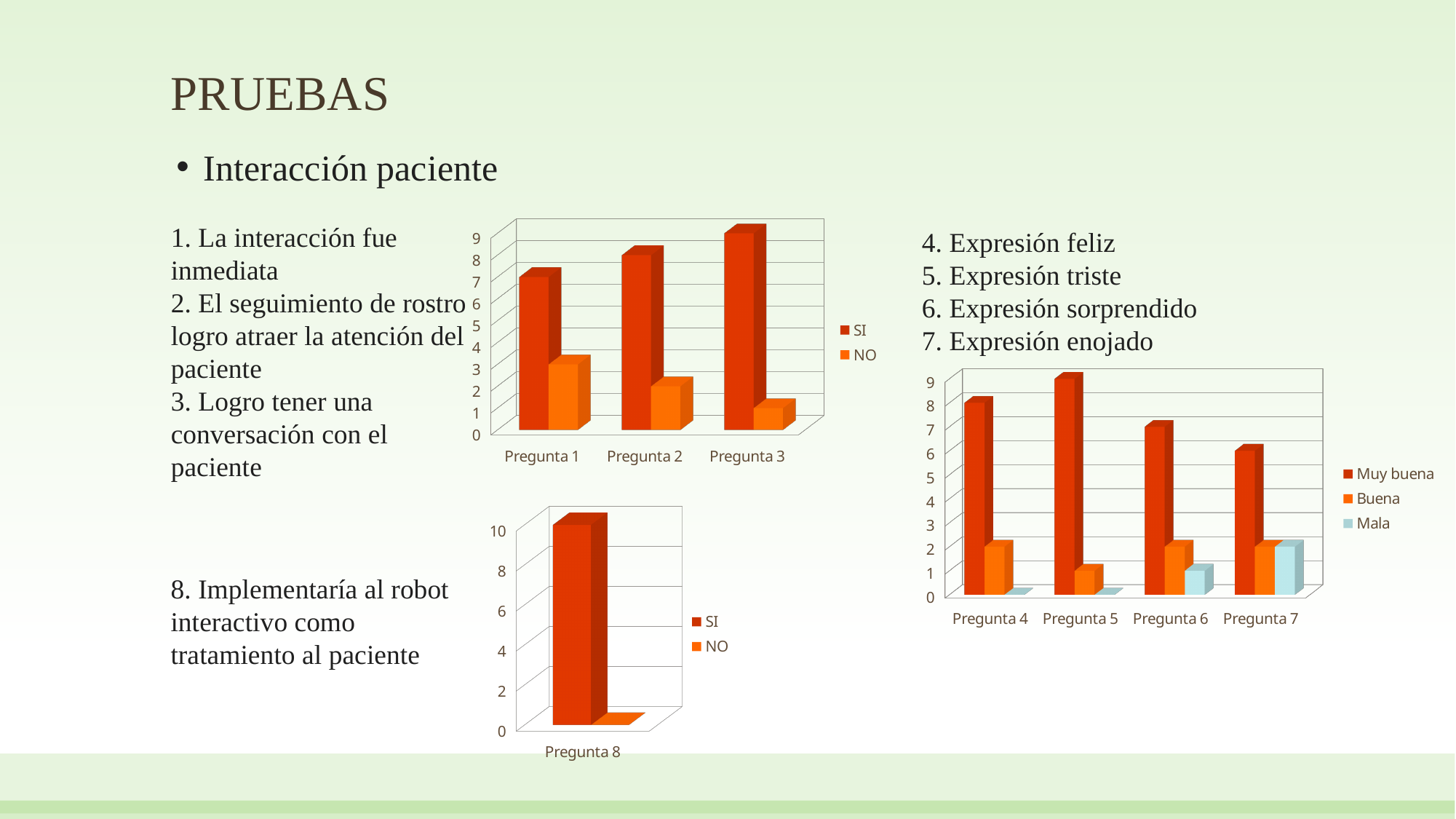
In the top-left chart (Pregunta 1 to Pregunta 3), how many series does the legend list? 2 What kind of chart is the bottom-left chart (Pregunta 8)? bar chart In the right chart (Pregunta 4 to Pregunta 7), how many series does the legend list? 3 In the right chart (Pregunta 4 to Pregunta 7), how many categories are shown on the x axis? 4 In the bottom-left chart (Pregunta 8), is the SI value greater or less than 8? greater In the right chart (Pregunta 4 to Pregunta 7), which category has the highest Muy buena value? Pregunta 5 In the right chart (Pregunta 4 to Pregunta 7), which has the larger Mala value, Pregunta 4 or Pregunta 7? Pregunta 7 In the top-left chart (Pregunta 1 to Pregunta 3), do the SI values rise or fall from Pregunta 1 to Pregunta 3? rise In the bottom-left chart (Pregunta 8), which is larger, SI or NO? SI In the top-left chart (Pregunta 1 to Pregunta 3), which category has the lowest NO value? Pregunta 3 In the top-left chart (Pregunta 1 to Pregunta 3), which category has the highest SI value? Pregunta 3 In the top-left chart (Pregunta 1 to Pregunta 3), is the SI value for Pregunta 1 greater or less than 5? greater